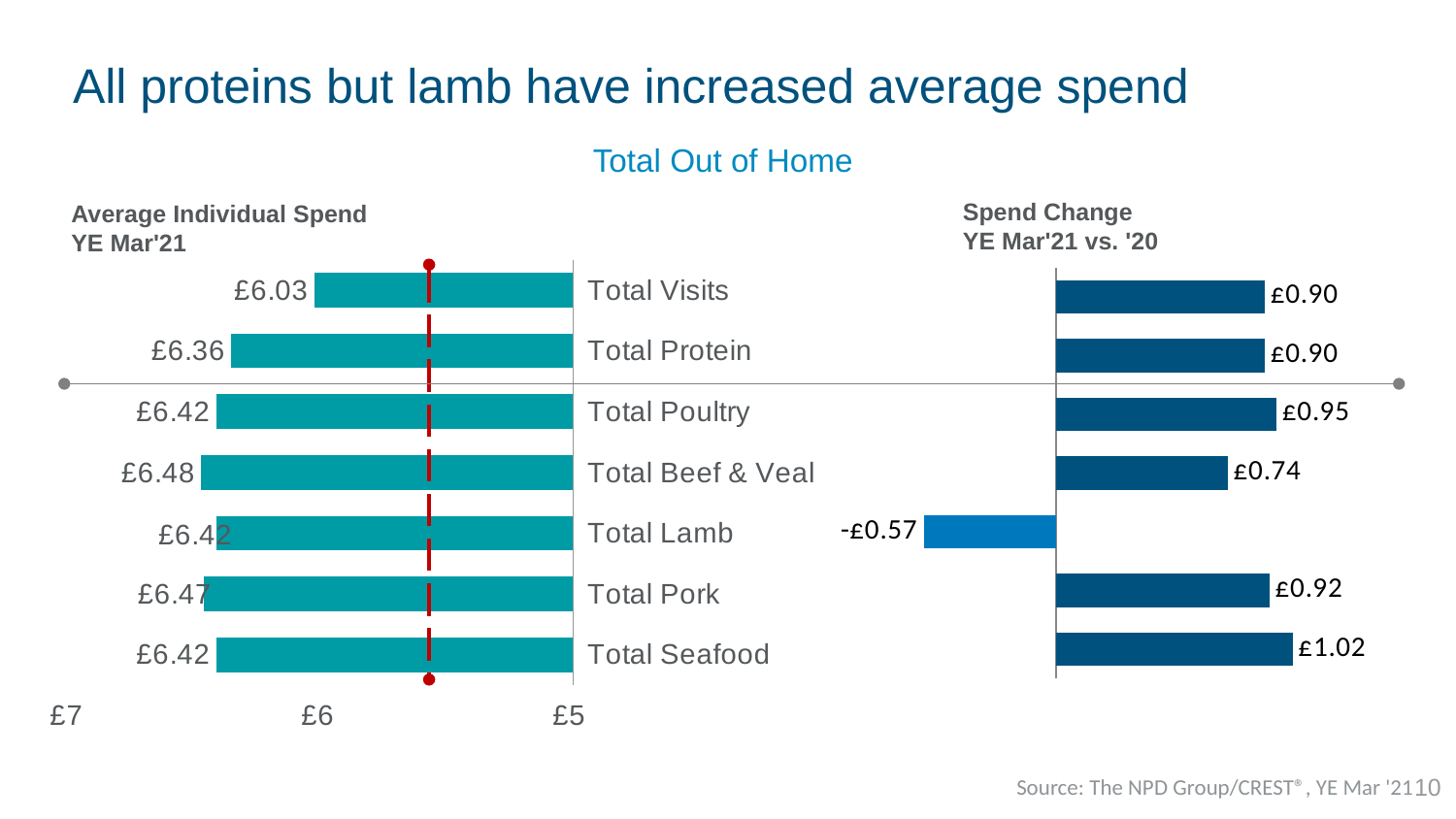
On the Spend Change chart, which category has the highest value? Total Seafood On the Average Individual Spend chart, is the value for Total Visits greater or less than £6? greater How many categories are shown on the Spend Change chart? 7 On the Average Individual Spend chart, what is the value for Total Visits? £6.03 On the Average Individual Spend chart, which is larger, Total Protein or Total Visits? Total Protein On the Spend Change chart, what is the value for Total Seafood? £1.02 On the Spend Change chart, which category has the lowest value? Total Lamb What kind of chart is the Average Individual Spend chart? Bar chart On the Average Individual Spend chart, what is the value for Total Beef & Veal? £6.48 On the Spend Change chart, what is the difference between Total Seafood and Total Beef & Veal? £0.28 On the Spend Change chart, what is the value for Total Lamb? -£0.57 On the Average Individual Spend chart, which category has the lowest value? Total Visits